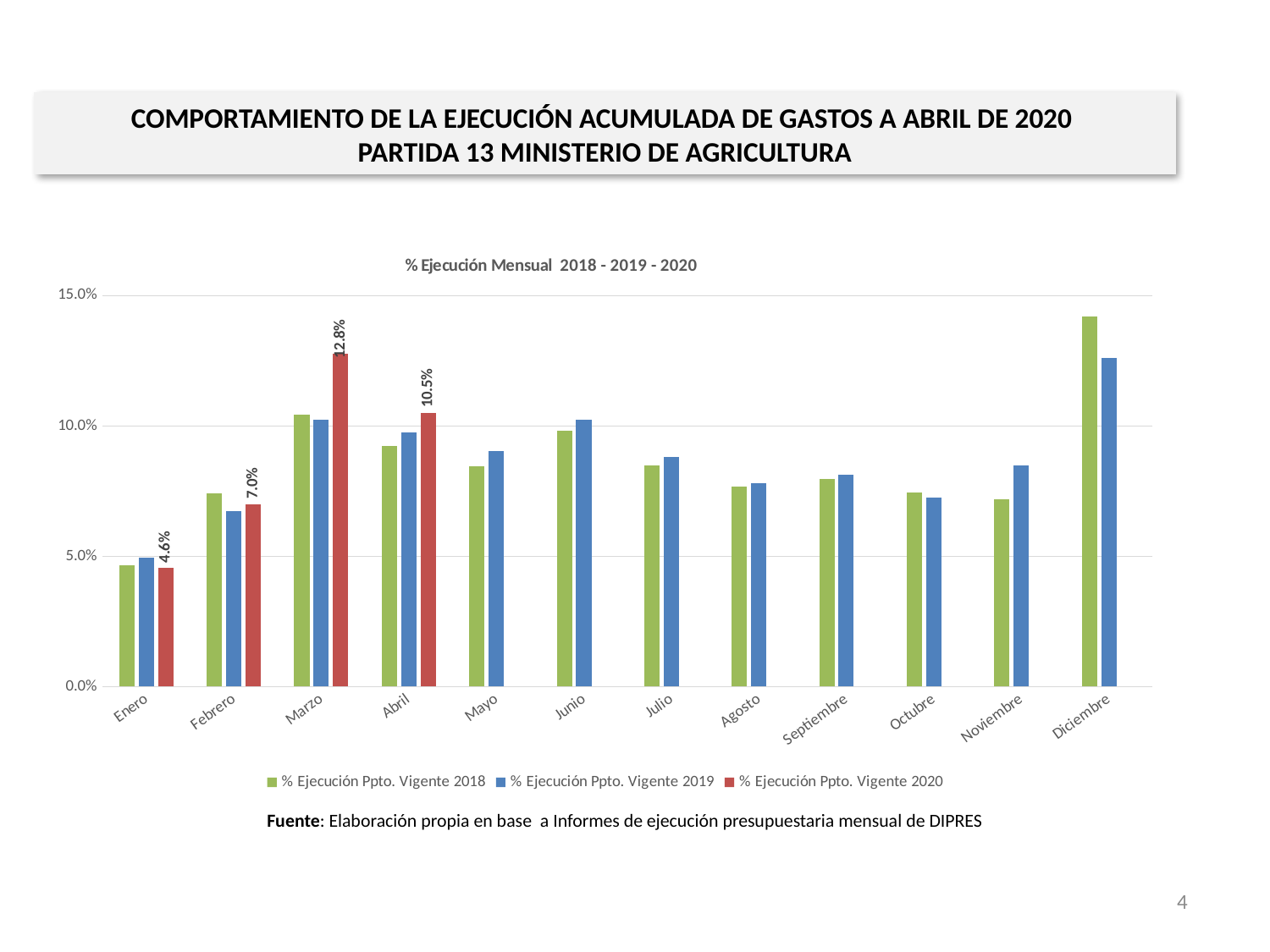
Is the value for Octubre in the % Ejecución Ppto. Vigente 2019 series greater or less than 10.0%? less How many months are shown on the x axis of the chart? 12 What is the difference between the Marzo and Abril values in the % Ejecución Ppto. Vigente 2020 series? 2.3 percentage points What is the value for Marzo in the % Ejecución Ppto. Vigente 2020 series? 12.8% Which month has the lowest value in the % Ejecución Ppto. Vigente 2020 series? Enero What is the value for Enero in the % Ejecución Ppto. Vigente 2020 series? 4.6% What is the value for Abril in the % Ejecución Ppto. Vigente 2020 series? 10.5% What type of chart is shown on the slide? Bar chart How many series does the chart legend list? 3 Is the value for Diciembre in the % Ejecución Ppto. Vigente 2018 series greater or less than 10.0%? greater Which month has the highest value in the % Ejecución Ppto. Vigente 2020 series? Marzo In the % Ejecución Ppto. Vigente 2020 series, which is larger: Febrero or Abril? Abril